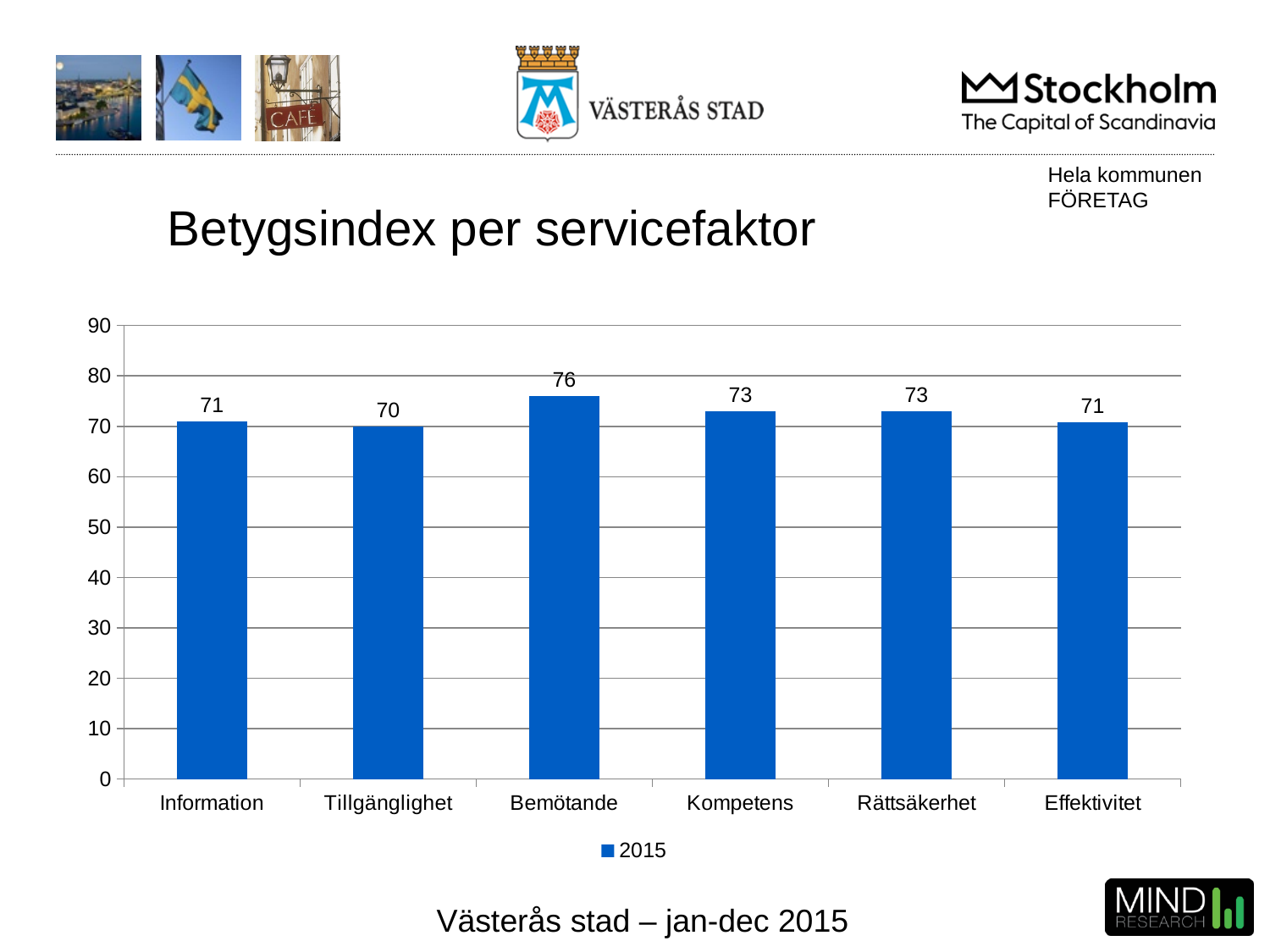
What kind of chart is shown? bar chart What is the value for Tillgänglighet? 70 How many series does the legend list? 1 What is the value for Kompetens? 73 Is the value for Information greater or less than 60? greater Which service factor has the lowest value? Tillgänglighet What is the difference between the values for Bemötande and Tillgänglighet? 6 What is the value for Bemötande? 76 Which service factor has the highest value? Bemötande How many service factors are shown on the x axis? 6 What year does the legend entry show? 2015 Which is larger, the value for Rättsäkerhet or the value for Effektivitet? Rättsäkerhet